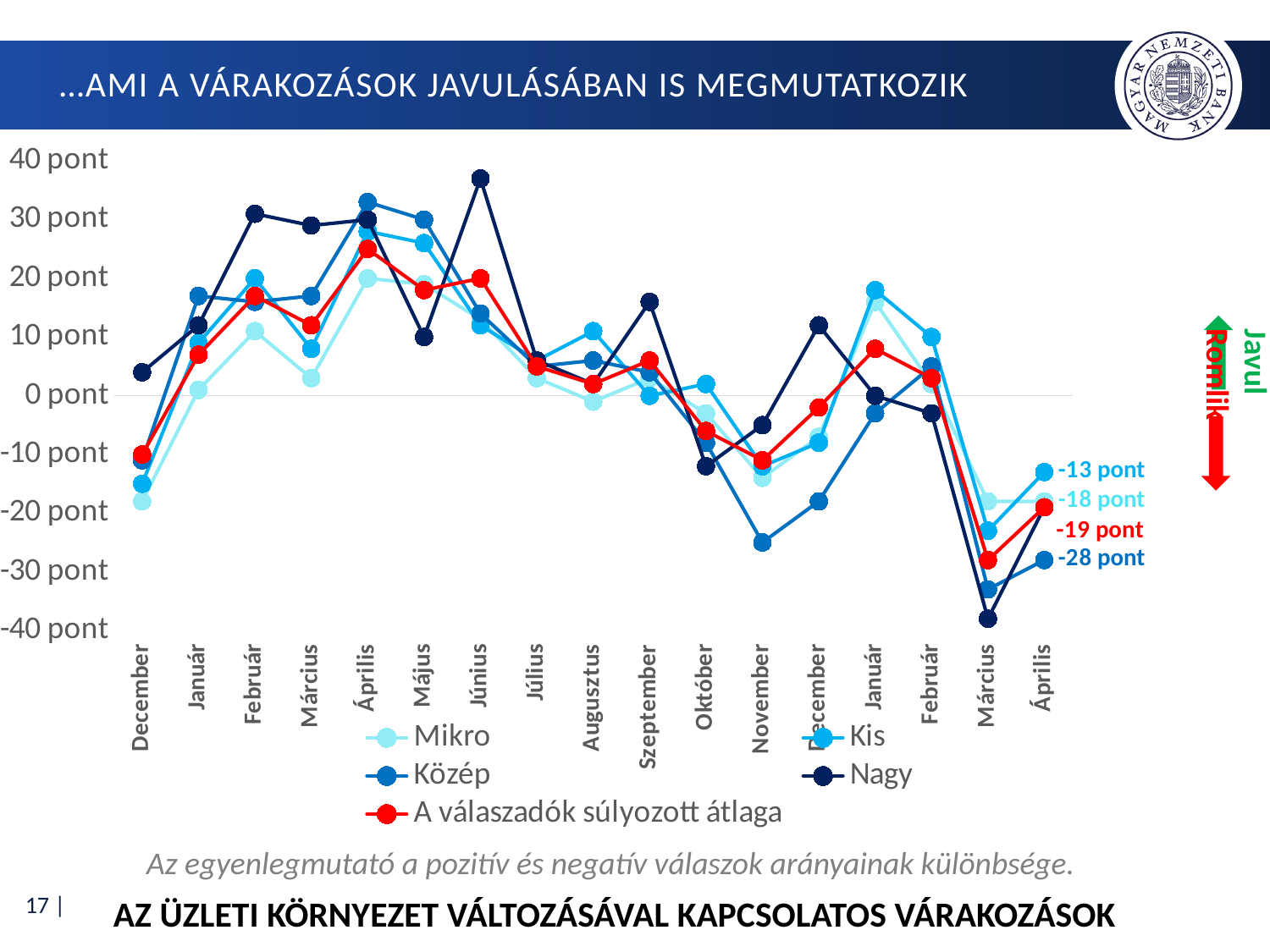
What type of chart is shown on the slide? line chart How many months are shown along the x axis? 17 Is the value of the Nagy series in Június greater or less than 30 pont? greater What is the value of 'A válaszadók súlyozott átlaga' in the final Április? -19 pont How many series does the legend list? 5 In the final Április, what is the difference between the Kis value and the Közép value? 15 pont Does the weighted average series ('A válaszadók súlyozott átlaga') rise or fall from the second Február to the second Március? fall What is the value of the Közép series in the final Április? -28 pont In the final Április, which is higher: the Kis series or the Közép series? Kis What is the value of the Kis series in the final Április? -13 pont What is the value of the Mikro series in the final Április? -18 pont Is the value of the Közép series in November greater or less than -20 pont? less